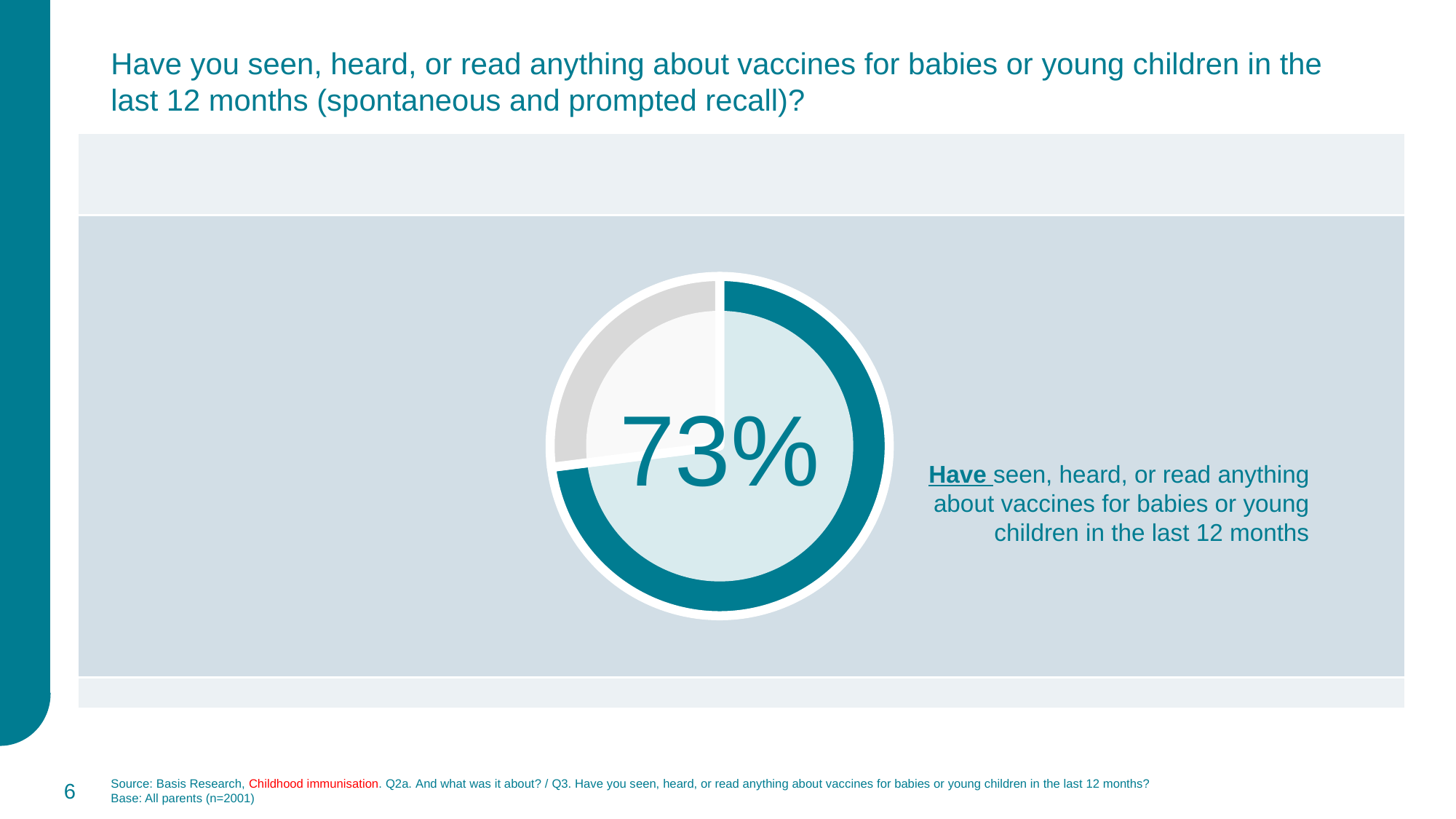
What value is printed in the centre of the chart? 73% What kind of chart is shown on the slide? pie chart Is the share of parents who have seen, heard, or read anything about vaccines greater or less than 50%? greater Which slice is larger: the teal 'Have seen' slice or the grey slice? the teal 'Have seen' slice What share of the pie is taken by the slice that is not the 73% 'Have seen' slice? 27% Is the share of parents who have not seen, heard, or read anything about vaccines greater or less than 50%? less How many slices does the pie chart have? 2 What is the base (sample size) stated for the chart? All parents (n=2001) What percentage of parents have seen, heard, or read anything about vaccines for babies or young children in the last 12 months? 73% What colour is the slice representing parents who have seen, heard, or read anything about vaccines? teal